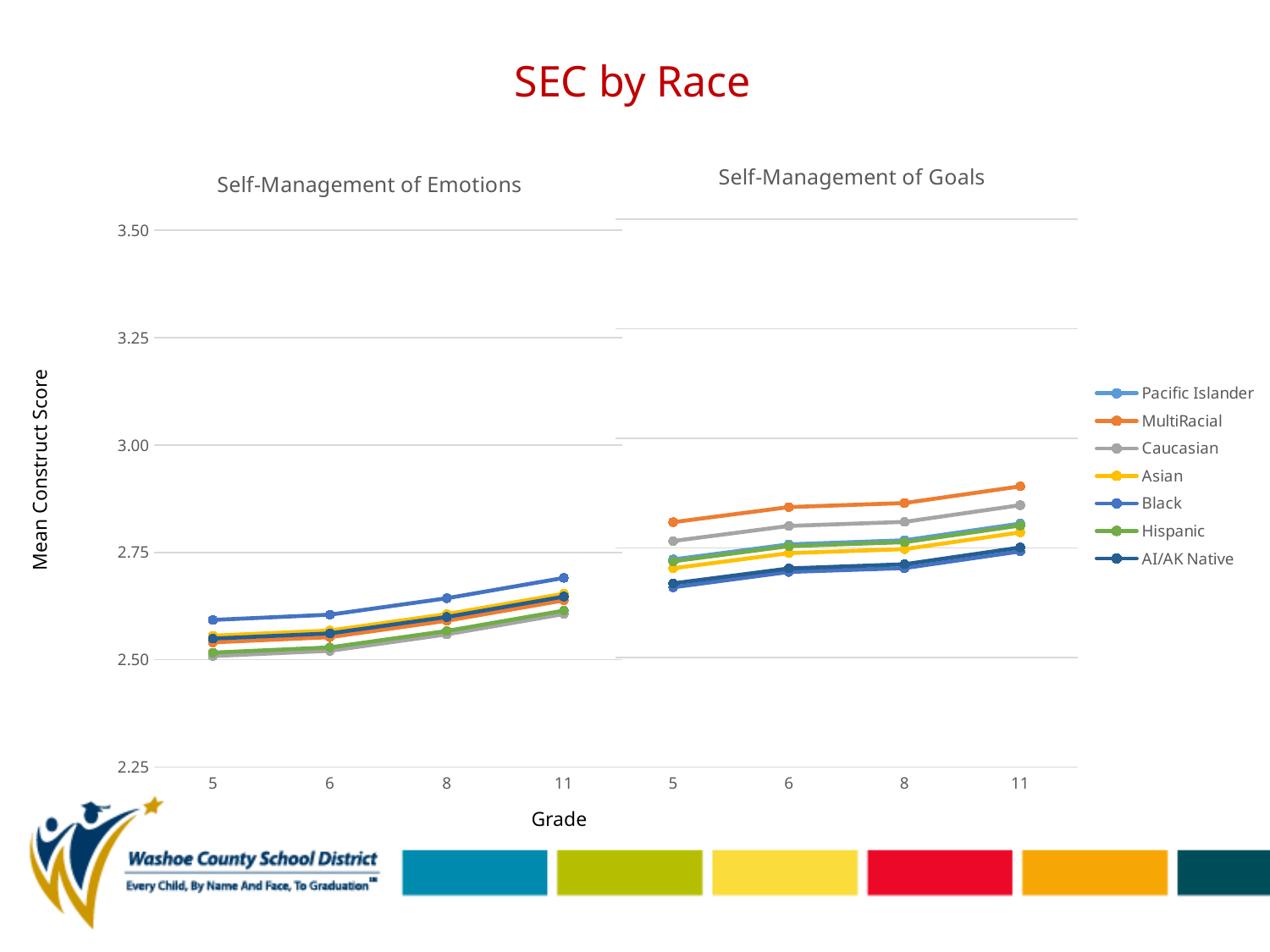
How many series does the legend list? 7 In the Self-Management of Goals chart, which is larger at grade 11: MultiRacial or Black? MultiRacial What kind of chart is the Self-Management of Emotions chart? line chart In the Self-Management of Emotions chart, which race group has the highest score at grade 8? Black In the Self-Management of Goals chart, is the value for MultiRacial at grade 11 greater or less than 3.00? less In the Self-Management of Emotions chart, is the value for Black at grade 11 greater or less than 2.75? less What is the title of the slide? SEC by Race In the Self-Management of Goals chart, which race group has the highest score at grade 11? MultiRacial What is the label of the y axis shared by the two charts? Mean Construct Score In the Self-Management of Emotions chart, do the scores rise or fall from grade 5 to grade 11? rise In the Self-Management of Goals chart, is the value for MultiRacial at grade 5 greater or less than 2.75? greater How many grade levels are plotted on the x axis of the Self-Management of Goals chart? 4